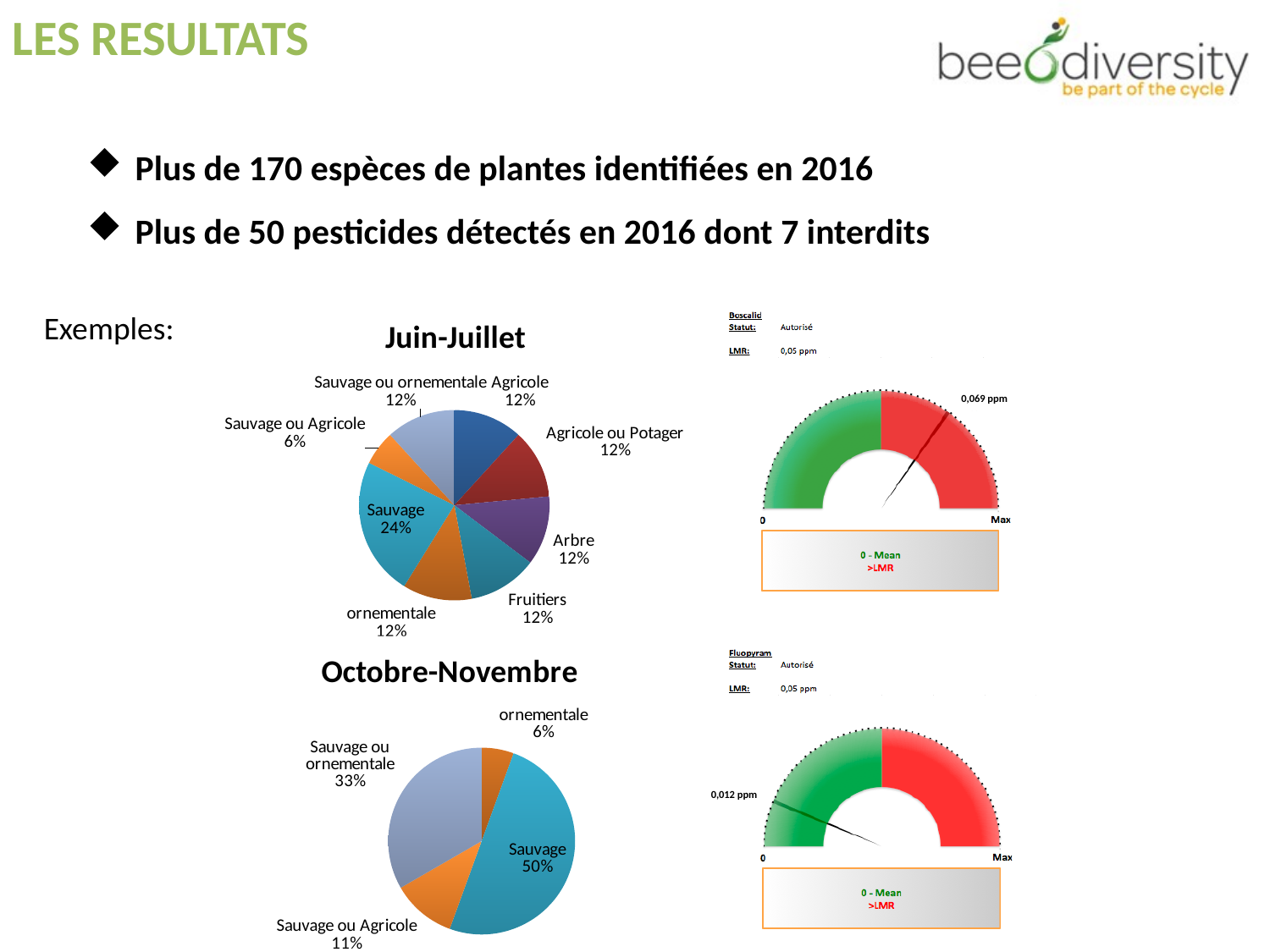
In the Juin-Juillet pie chart, which category has the largest share? Sauvage How many categories are shown in the Juin-Juillet pie chart? 8 In the Juin-Juillet pie chart, which category has the smallest share? Sauvage ou Agricole In the Octobre-Novembre pie chart, which category has the smallest share? ornementale In the Octobre-Novembre pie chart, which category has the largest share? Sauvage What type of chart is the Octobre-Novembre chart? Pie chart In the Juin-Juillet pie chart, what share does Sauvage ou Agricole have? 6% On the Boscalid gauge at the top right, what value does the needle indicate? 0,069 ppm In the Juin-Juillet pie chart, what share does Sauvage have? 24% In the Octobre-Novembre pie chart, what is the difference between the shares of Sauvage and Sauvage ou Agricole? 39% In the Octobre-Novembre pie chart, what share does Sauvage ou ornementale have? 33% How many categories are shown in the Octobre-Novembre pie chart? 4